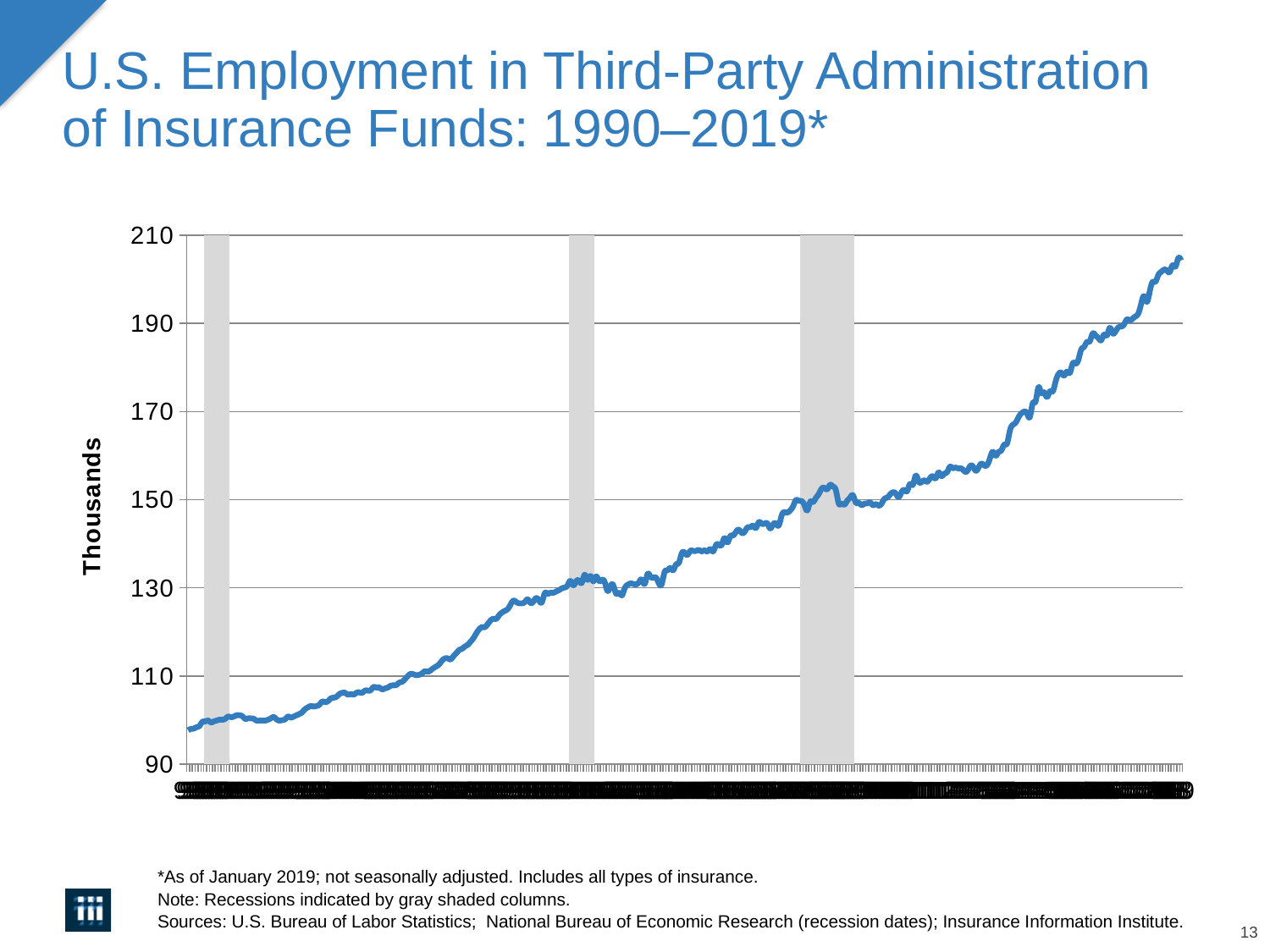
Is the highest value reached by the line greater or less than 210? less Is the lowest value of the line greater or less than 90? greater What is the highest value shown on the vertical axis? 210 What is the label on the vertical axis of the chart? Thousands Is the value at the start of the series (left end of the line) greater or less than 110? less What is the title of the chart? U.S. Employment in Third-Party Administration of Insurance Funds: 1990–2019* Which is larger, the value at the left end of the line or the value at the right end of the line? the right end Overall, do the values rise or fall from the left to the right of the chart? rise How many gray shaded recession columns are shown on the chart? 3 What kind of chart is shown on the slide? line chart